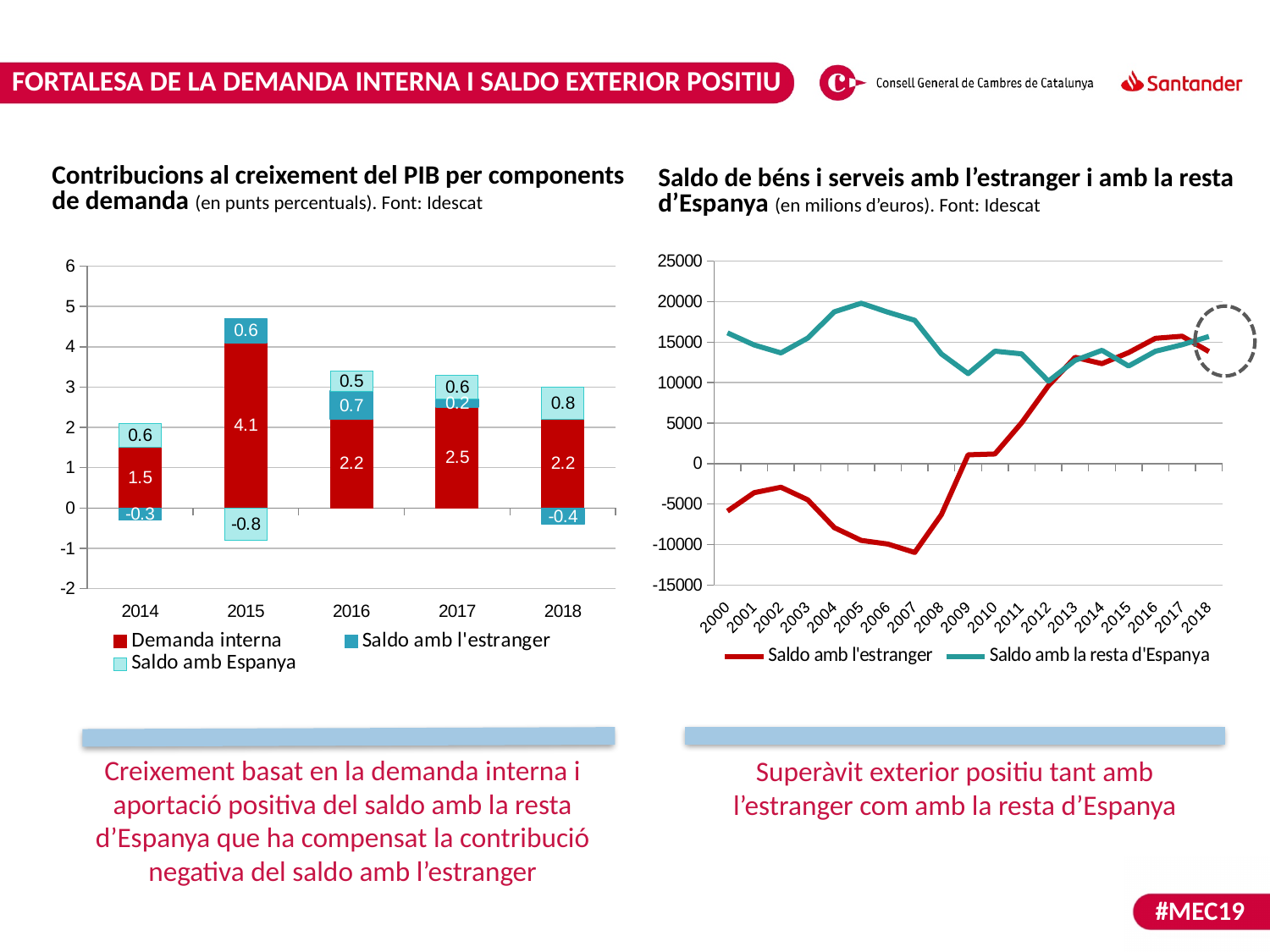
In the right chart (Saldo de béns i serveis), is the value of Saldo amb la resta d'Espanya in 2005 greater or less than 15000? greater In the left chart (Contribucions al creixement del PIB), what is the value of Saldo amb l'estranger for 2018? -0.4 In the left chart (Contribucions al creixement del PIB), which is larger: Saldo amb l'estranger in 2016 or in 2017? 2016 In the right chart (Saldo de béns i serveis), is the value of Saldo amb l'estranger in 2005 greater or less than -5000? less In the left chart (Contribucions al creixement del PIB), in which year is Demanda interna highest? 2015 In the left chart (Contribucions al creixement del PIB), what is the value of Demanda interna for 2015? 4.1 What kind of chart is the right chart (Saldo de béns i serveis amb l'estranger i amb la resta d'Espanya)? Line chart In the right chart (Saldo de béns i serveis), how many years are shown on the x axis? 19 In the left chart (Contribucions al creixement del PIB), what is the total of the stacked bar for 2016? 3.4 In the left chart (Contribucions al creixement del PIB), what is the difference between Demanda interna in 2015 and in 2014? 2.6 In the left chart (Contribucions al creixement del PIB), what is the value of Saldo amb Espanya for 2016? 0.5 In the left chart (Contribucions al creixement del PIB), how many series does the legend list? 3